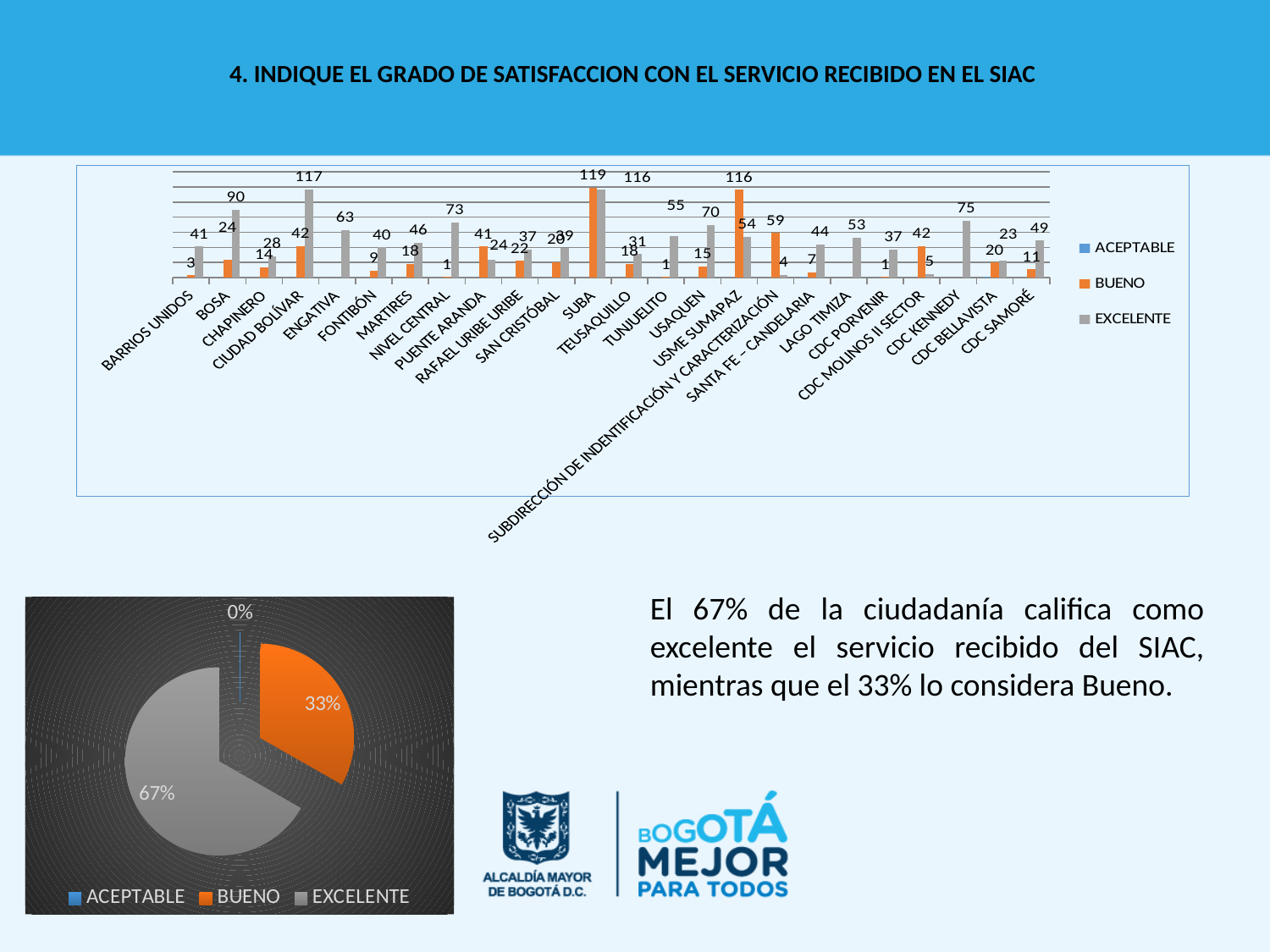
In the pie chart, what share is EXCELENTE? 67% In the bar chart, what is the difference between the EXCELENTE and BUENO values for BOSA? 66 In the bar chart, which is larger: the EXCELENTE value for CIUDAD BOLÍVAR or the EXCELENTE value for BOSA? CIUDAD BOLÍVAR In the bar chart, what is the BUENO value for USME SUMAPAZ? 116 In the pie chart, what share is BUENO? 33% How many series does the legend of the bar chart list? 3 What kind of chart is the chart at the top of the slide? Bar chart In the bar chart, what is the EXCELENTE value for NIVEL CENTRAL? 73 In the bar chart, what is the EXCELENTE value for CIUDAD BOLÍVAR? 117 In the bar chart, what is the BUENO value for SUBA? 119 In the bar chart, what is the EXCELENTE value for BOSA? 90 In the pie chart, which category has the smallest share? ACEPTABLE